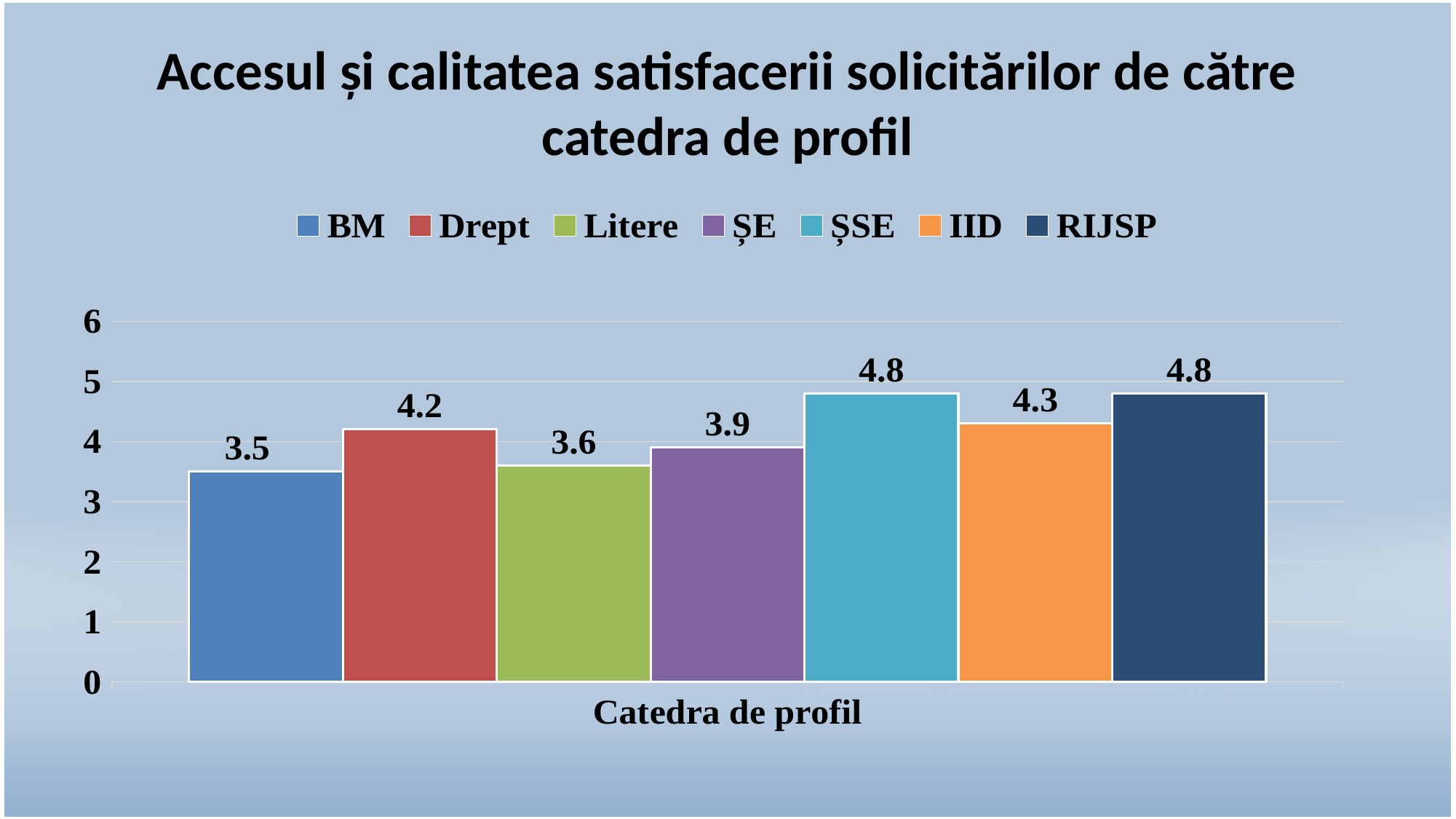
Which series has the lowest value? BM What is the value for BM? 3.5 How many series does the legend list? 7 What is the value for Drept? 4.2 Is the value for RIJSP greater or less than 4? greater What is the difference between the values for IID and BM? 0.8 Which is larger, the value for Drept or the value for Litere? Drept What is the difference between the values for ȘSE and Litere? 1.2 What is the value for IID? 4.3 What is the value for ȘE? 3.9 What kind of chart is shown on the slide? bar chart What is the label of the horizontal axis? Catedra de profil